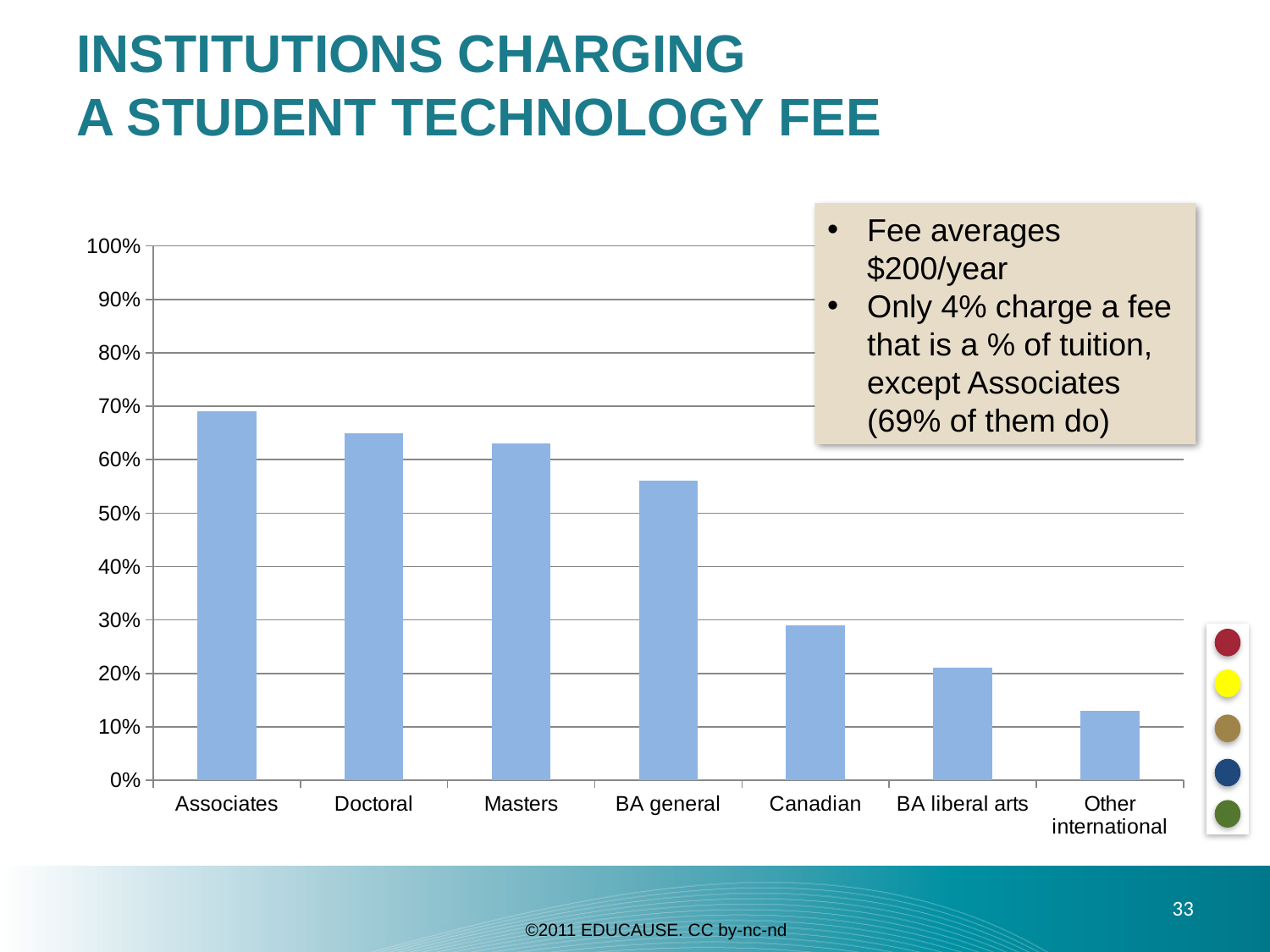
Is the value for Associates greater or less than 60%? greater Which category has the highest bar in the chart? Associates Do the bar values rise or fall moving from left to right along the x axis? fall What is the title of the slide containing the chart? INSTITUTIONS CHARGING A STUDENT TECHNOLOGY FEE Which is larger, the value for Doctoral or the value for BA liberal arts? Doctoral Is the value for BA general greater or less than 50%? greater Which category has the lowest bar in the chart? Other international How many institution categories are shown on the x axis of the chart? 7 Is the value for Canadian greater or less than 40%? less Which is larger, the value for Canadian or the value for Masters? Masters What kind of chart is shown on the slide? bar chart